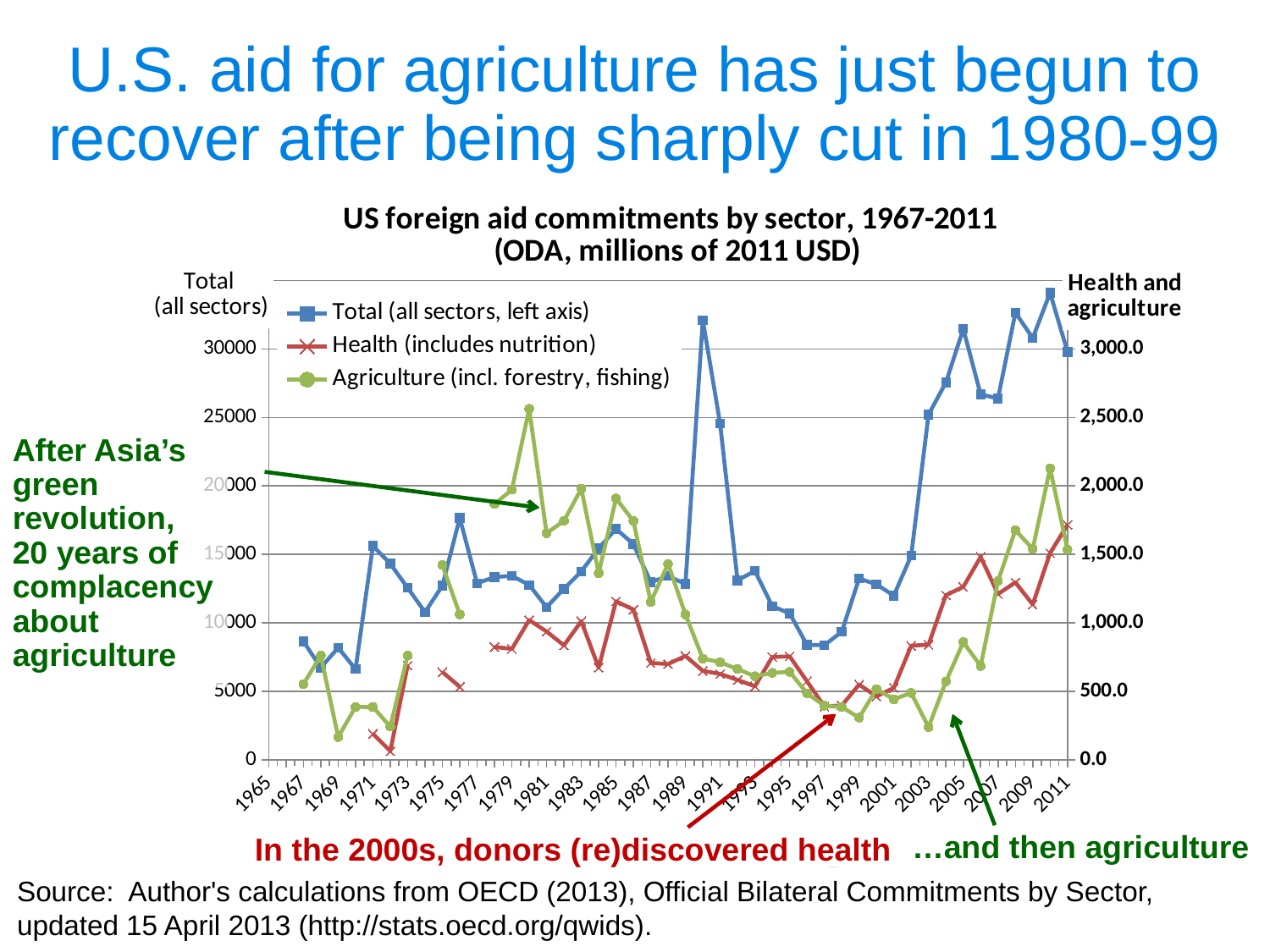
How many series does the chart's legend list? 3 Is the value for Health in 2011 greater or less than 1,500.0? greater Is the value for Agriculture in 2004 greater or less than 500.0? greater What kind of chart is shown on the slide? Line chart Does the Total (all sectors) series rise or fall between 2003 and 2006? Rise Does the Agriculture series generally rise or fall between 1981 and 1997? Fall In which year does the Agriculture series reach its highest value? 1980 What is the title of the chart? US foreign aid commitments by sector, 1967-2011 (ODA, millions of 2011 USD) Which series is plotted against the left axis according to the legend? Total (all sectors, left axis) Is the value for Total (all sectors) in 1991 greater or less than 30000? less Which is larger in 1991, the Total (all sectors) value or the Total value in 1993? 1991